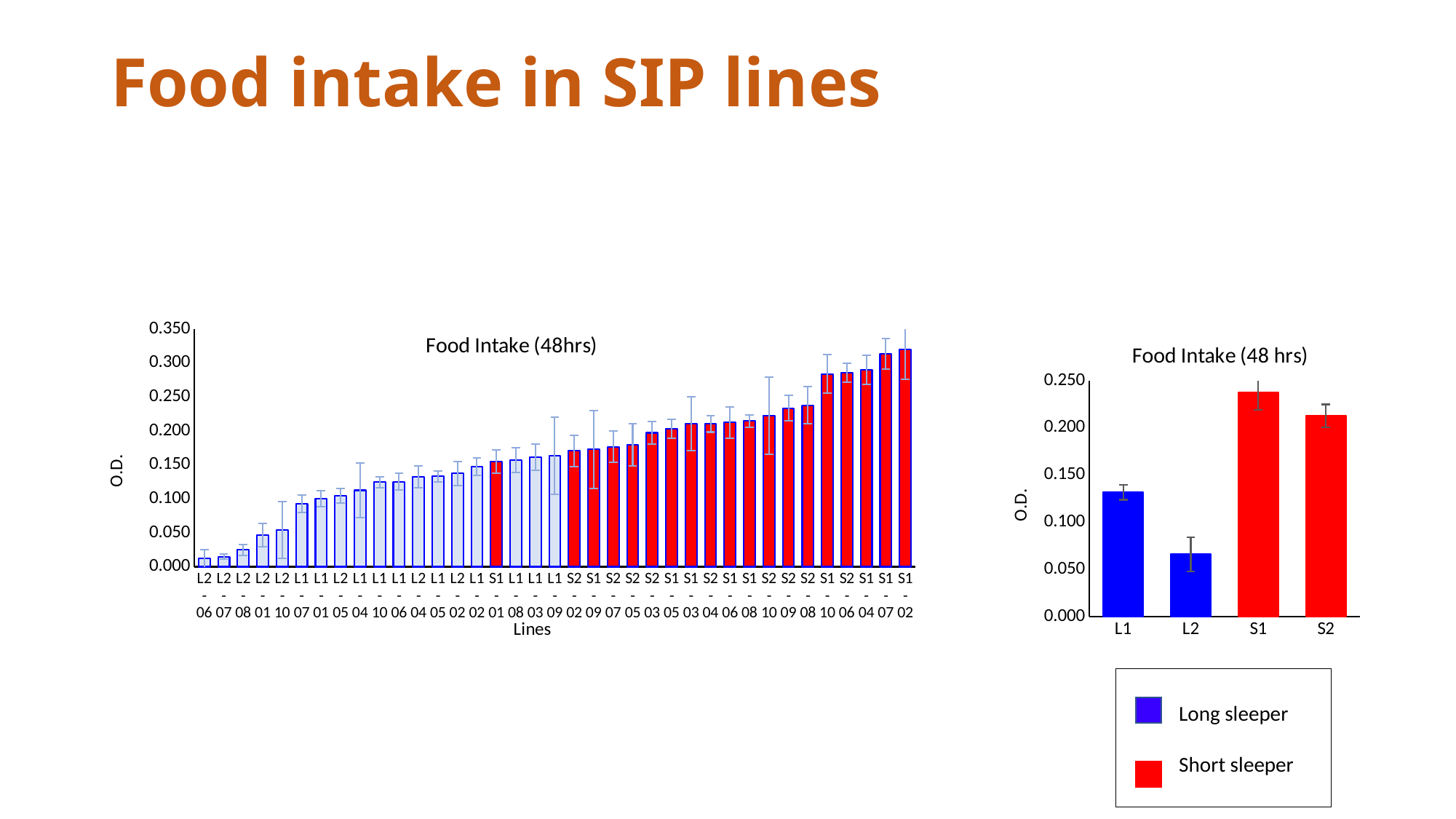
In the left-hand chart (Food Intake (48hrs)), do the values rise or fall from left to right along the x axis? rise In the right-hand chart (Food Intake (48 hrs)), which is larger, the value for L1 or the value for L2? L1 In the right-hand chart (Food Intake (48 hrs)), is the value for L2 greater or less than 0.100? less In the right-hand chart (Food Intake (48 hrs)), is the value for S1 greater or less than 0.200? greater In the right-hand chart (Food Intake (48 hrs)), which is larger, the value for S1 or the value for S2? S1 In the right-hand chart (Food Intake (48 hrs)), which category has the lowest value? L2 In the right-hand chart (Food Intake (48 hrs)), which category has the highest value? S1 How many categories are shown on the x axis of the right-hand chart (Food Intake (48 hrs))? 4 What kind of chart is the left-hand chart (Food Intake (48hrs))? bar chart In the right-hand chart (Food Intake (48 hrs)), is the value for L1 greater or less than 0.100? greater How many entries does the legend on the slide list? 2